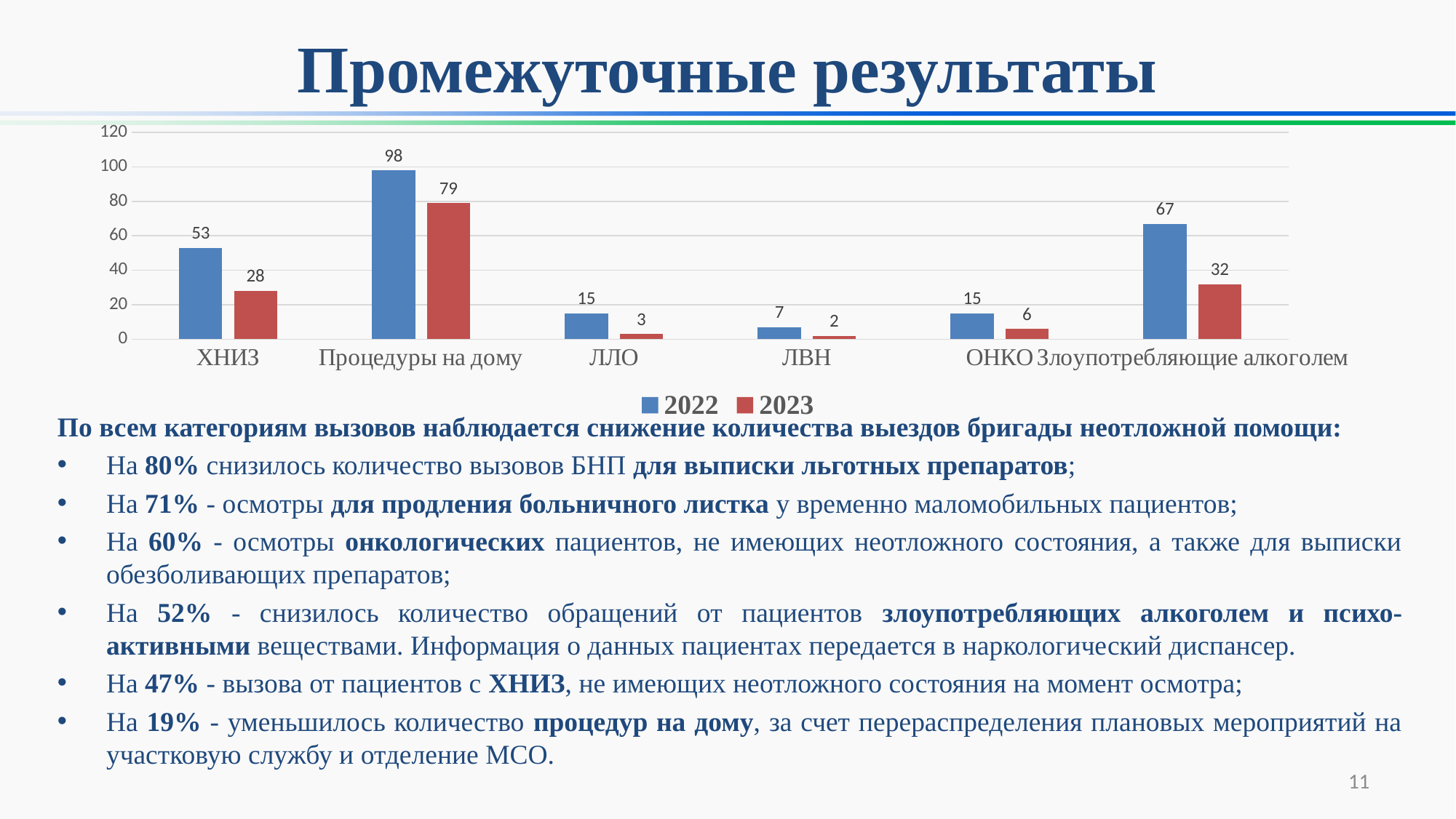
What is the difference between the 2022 and 2023 values for Процедуры на дому? 19 What kind of chart is shown on the slide? bar chart Which is larger: the 2022 value for ХНИЗ or the 2022 value for Злоупотребляющие алкоголем? Злоупотребляющие алкоголем Which colour represents the 2023 series in the legend? red How many categories are shown on the x axis? 6 What is the difference between the 2022 and 2023 values for ОНКО? 9 Which category has the lowest 2023 value? ЛВН What is the 2023 value for ХНИЗ? 28 How many series does the legend list? 2 Which category has the highest 2022 value? Процедуры на дому What is the 2023 value for Злоупотребляющие алкоголем? 32 What is the 2022 value for Процедуры на дому? 98